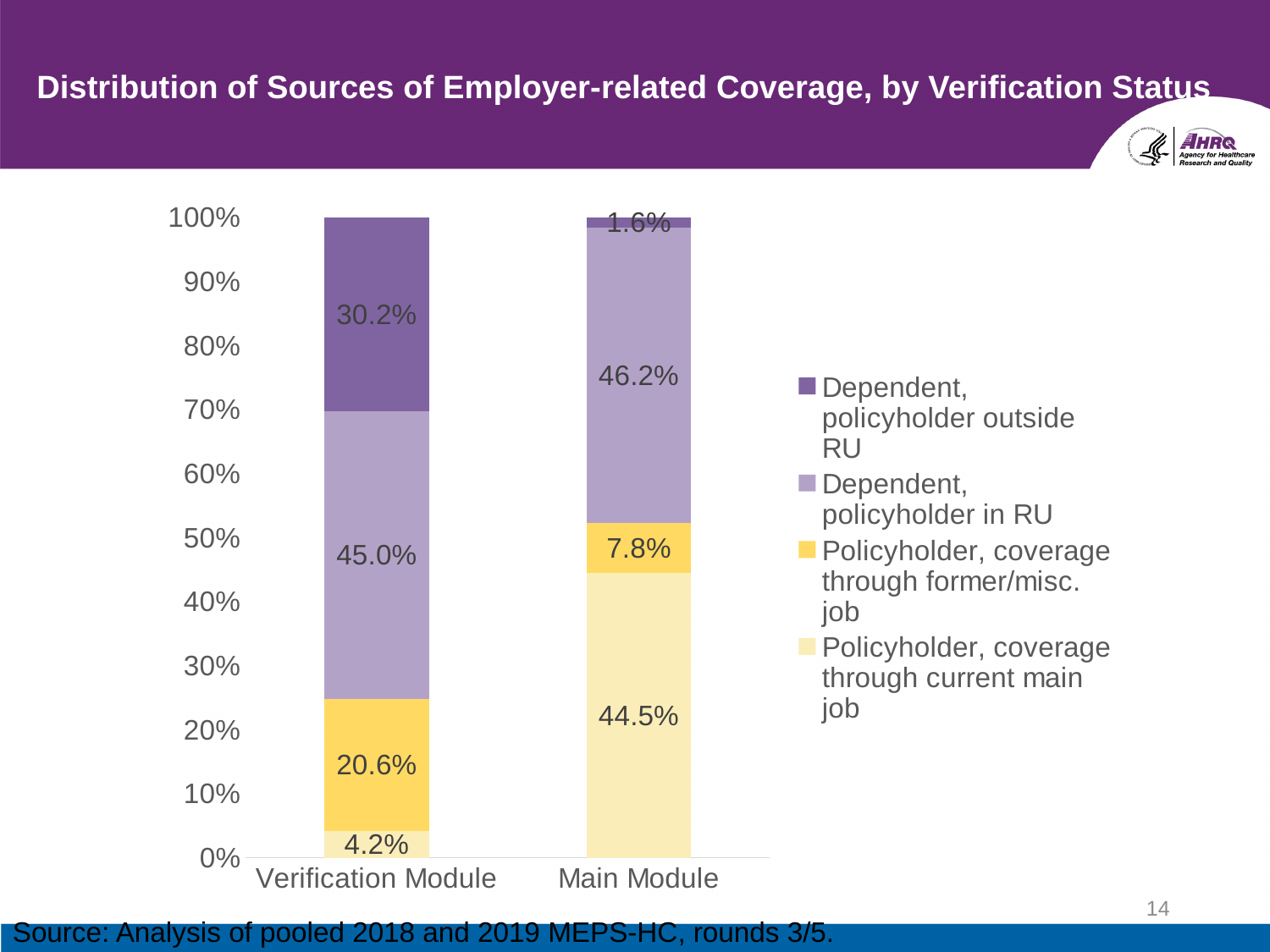
How many categories are shown on the x axis? 2 Which source has the smallest share in the Main Module? Dependent, policyholder outside RU What is the title of the chart? Distribution of Sources of Employer-related Coverage, by Verification Status What is the value for 'Dependent, policyholder in RU' in the Main Module? 46.2% Which is larger: 'Policyholder, coverage through former/misc. job' in the Verification Module or in the Main Module? Verification Module What is the value for 'Policyholder, coverage through former/misc. job' in the Verification Module? 20.6% What is the value for 'Policyholder, coverage through current main job' in the Main Module? 44.5% Which source has the largest share in the Verification Module? Dependent, policyholder in RU What is the value for 'Dependent, policyholder outside RU' in the Verification Module? 30.2% What is the difference between the 'Policyholder, coverage through current main job' values for the Main Module and the Verification Module? 40.3% What kind of chart is shown on the slide? Stacked bar chart How many series does the legend list? 4